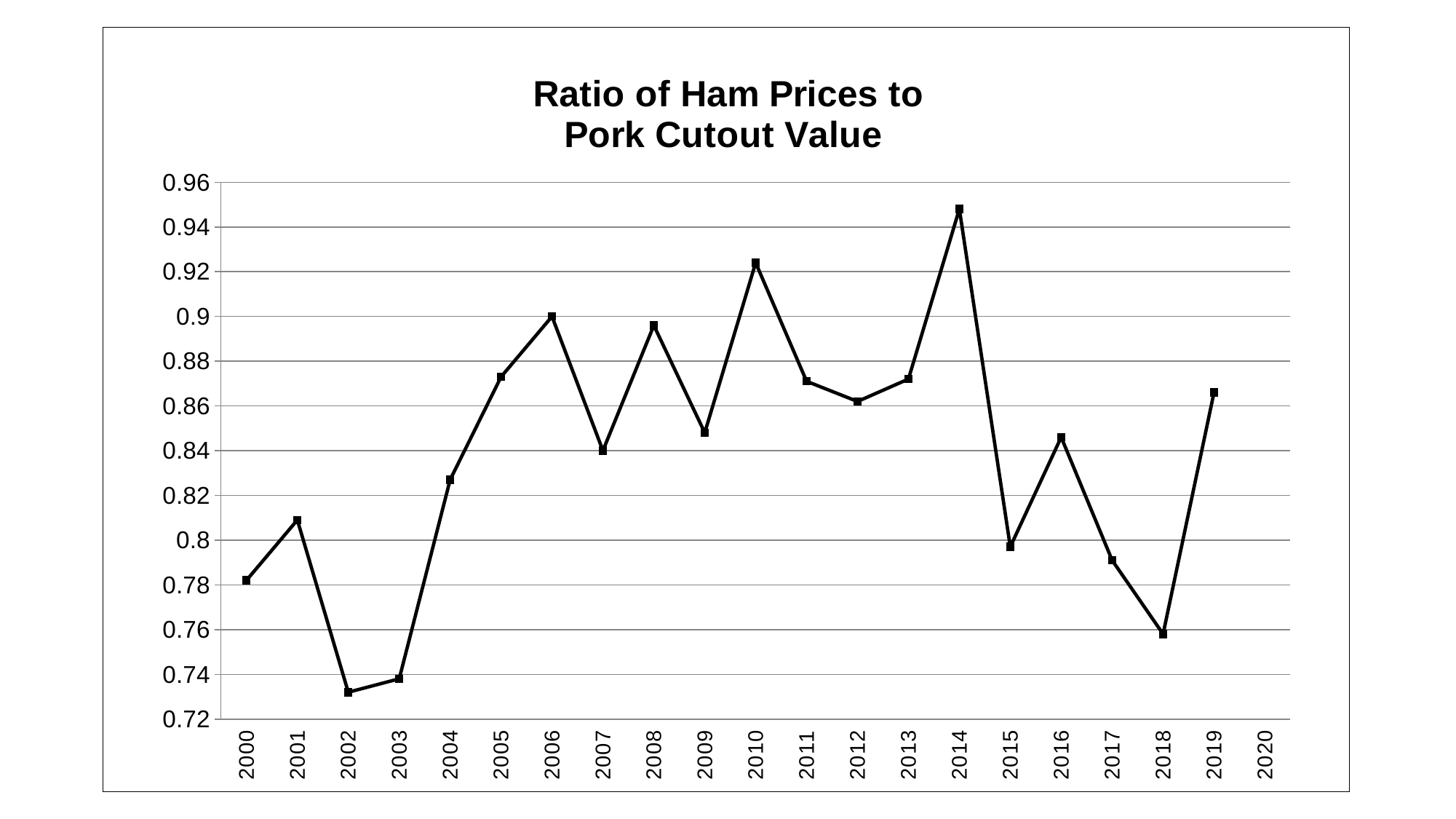
What kind of chart is shown on the slide? line chart Is the value for 2010 greater or less than 0.92? greater What is the title of the chart? Ratio of Ham Prices to Pork Cutout Value Is the value for 2014 greater or less than 0.94? greater Which year has the larger value, 2008 or 2010? 2010 Which year has the larger value, 2006 or 2016? 2006 How many years are labeled on the x axis? 21 Is the value for 2015 greater or less than 0.8? less Which year has the lowest ratio of ham prices to pork cutout value? 2002 Does the ratio rise or fall from 2002 to 2006? rise Which year has the highest ratio of ham prices to pork cutout value? 2014